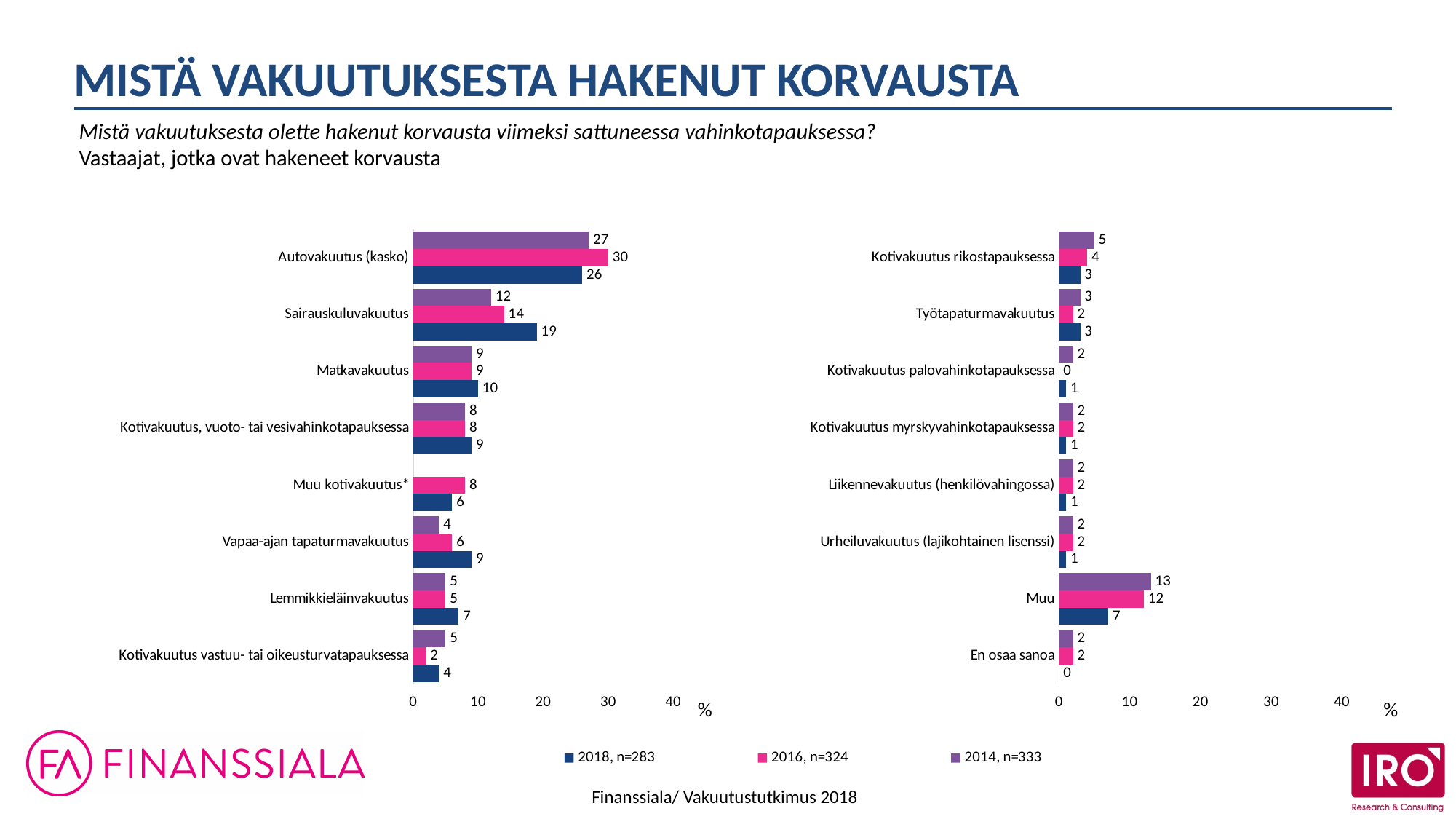
In the right chart, which category has the highest 2018 value? Muu In the right chart, what is the difference between the 2014 and 2018 values for Muu? 6 In the left chart, what is the 2016 value for Sairauskuluvakuutus? 14 How many series does the legend list? 3 In the left chart, what is the difference between the 2018 and 2014 values for Sairauskuluvakuutus? 7 How many categories are shown in the right chart? 8 In the left chart, which category has the highest 2016 value? Autovakuutus (kasko) In the left chart, what is the 2018 value for Autovakuutus (kasko)? 26 In the right chart, what is the 2016 value for Kotivakuutus palovahinkotapauksessa? 0 In the right chart, what is the 2014 value for Muu? 13 What type of chart is the left chart? Bar chart In the left chart, which is larger for Vapaa-ajan tapaturmavakuutus: the 2018 value or the 2014 value? 2018